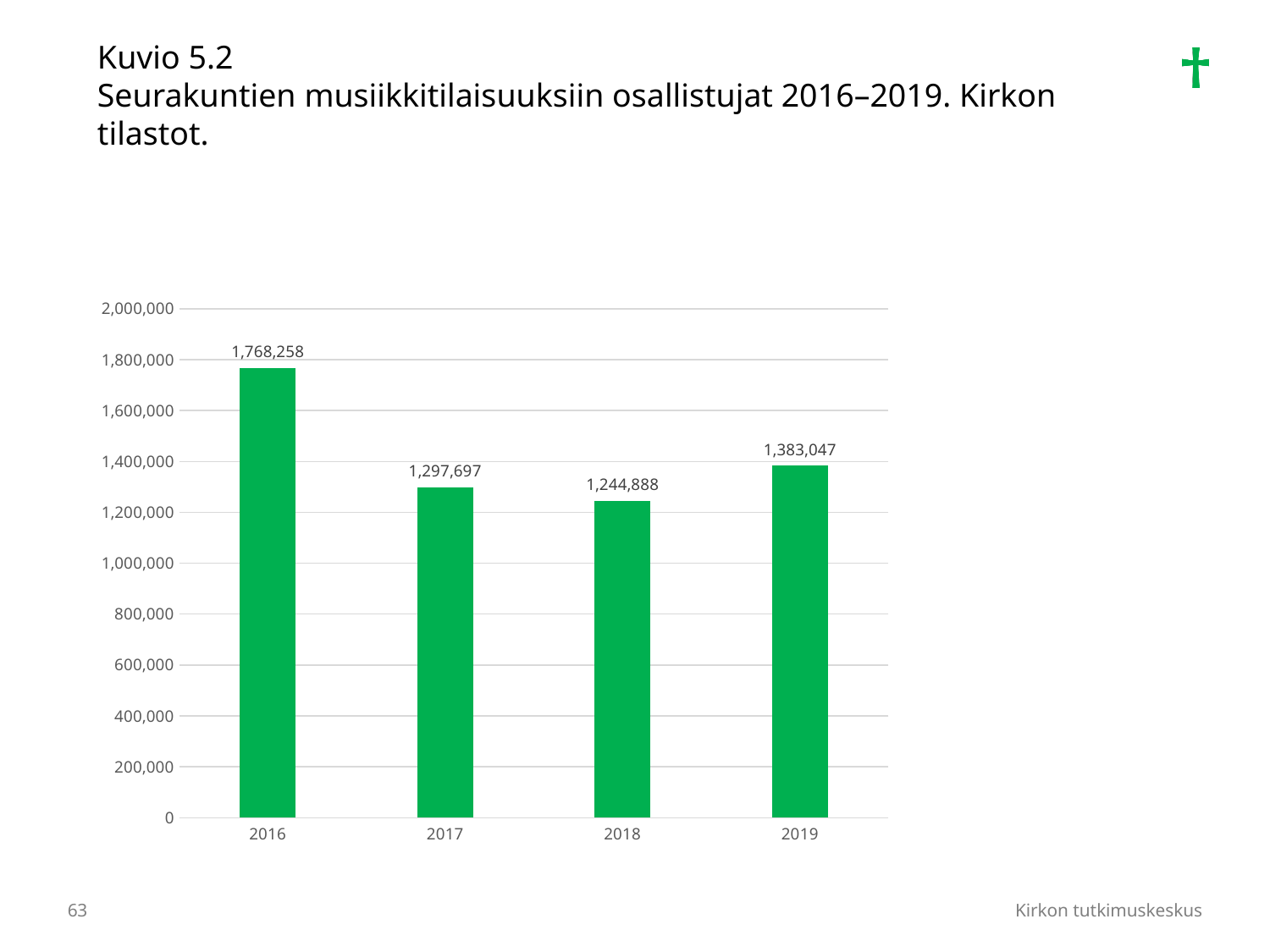
What is the value for 2016? 1,768,258 What is the value for 2018? 1,244,888 What is the difference between the values for 2019 and 2018? 138,159 What is the difference between the values for 2016 and 2017? 470,561 How many years are shown on the x axis? 4 Which is larger, the value for 2017 or the value for 2019? 2019 Which year has the lowest value? 2018 What kind of chart is shown on the slide? bar chart Do the values rise or fall from 2016 to 2018? fall Is the value for 2017 greater or less than 1,400,000? less What is the value for 2019? 1,383,047 Which year has the highest value? 2016